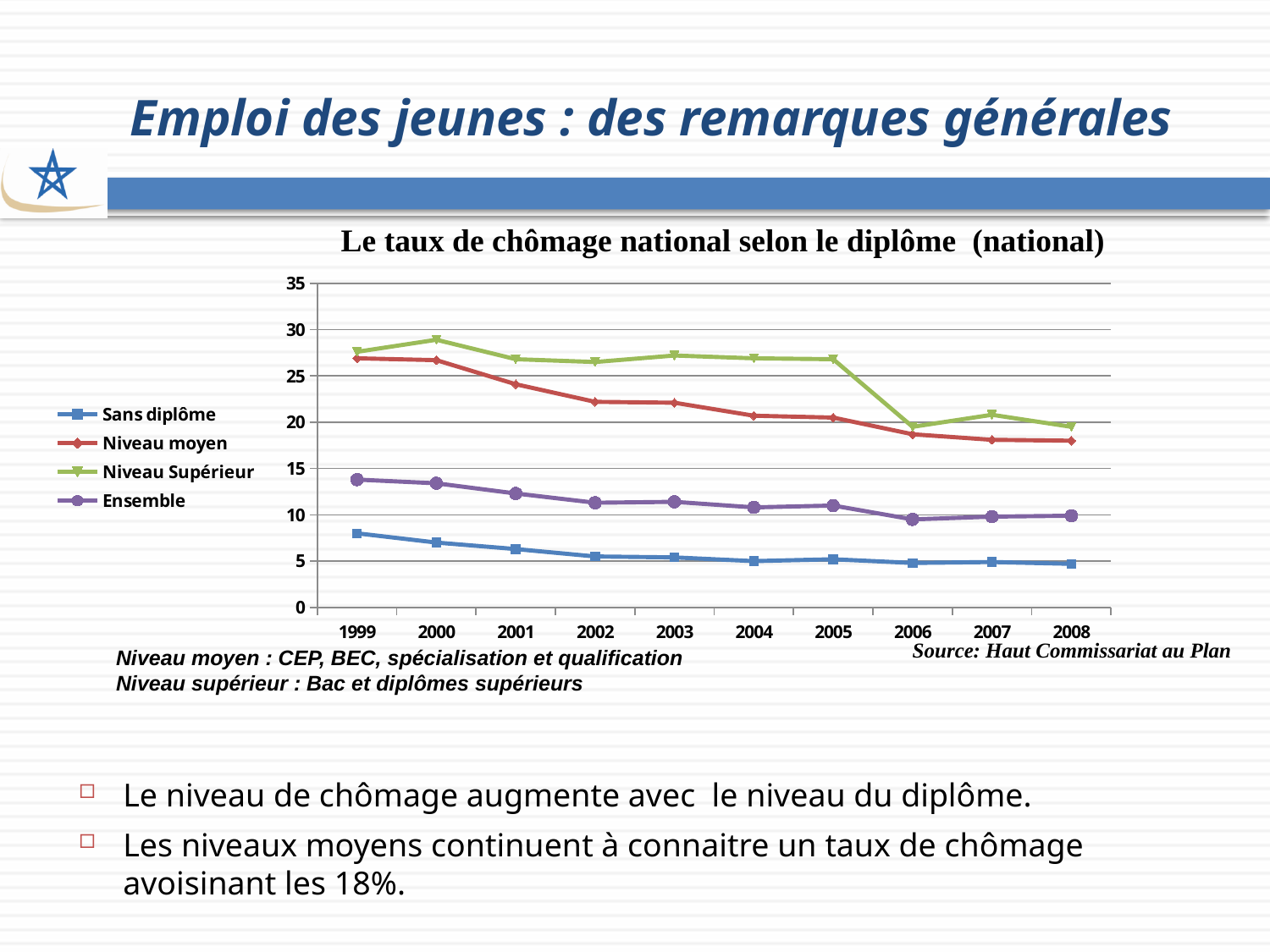
What is the title of the chart? Le taux de chômage national selon le diplôme (national) Which series has the lowest values across all years in the chart? Sans diplôme How many years are plotted along the x axis of the chart? 10 Is the value for Niveau moyen in 2008 greater or less than 20? less Is the value for Ensemble in 1999 greater or less than 10? greater Does the Sans diplôme series rise or fall from 1999 to 2008? Fall How many series does the legend of the chart list? 4 What kind of chart is shown on the slide? Line chart In 2008, which is larger: the value for Ensemble or the value for Sans diplôme? Ensemble Is the value for Niveau Supérieur in 2000 greater or less than 25? greater Which series has the highest value in 2005? Niveau Supérieur